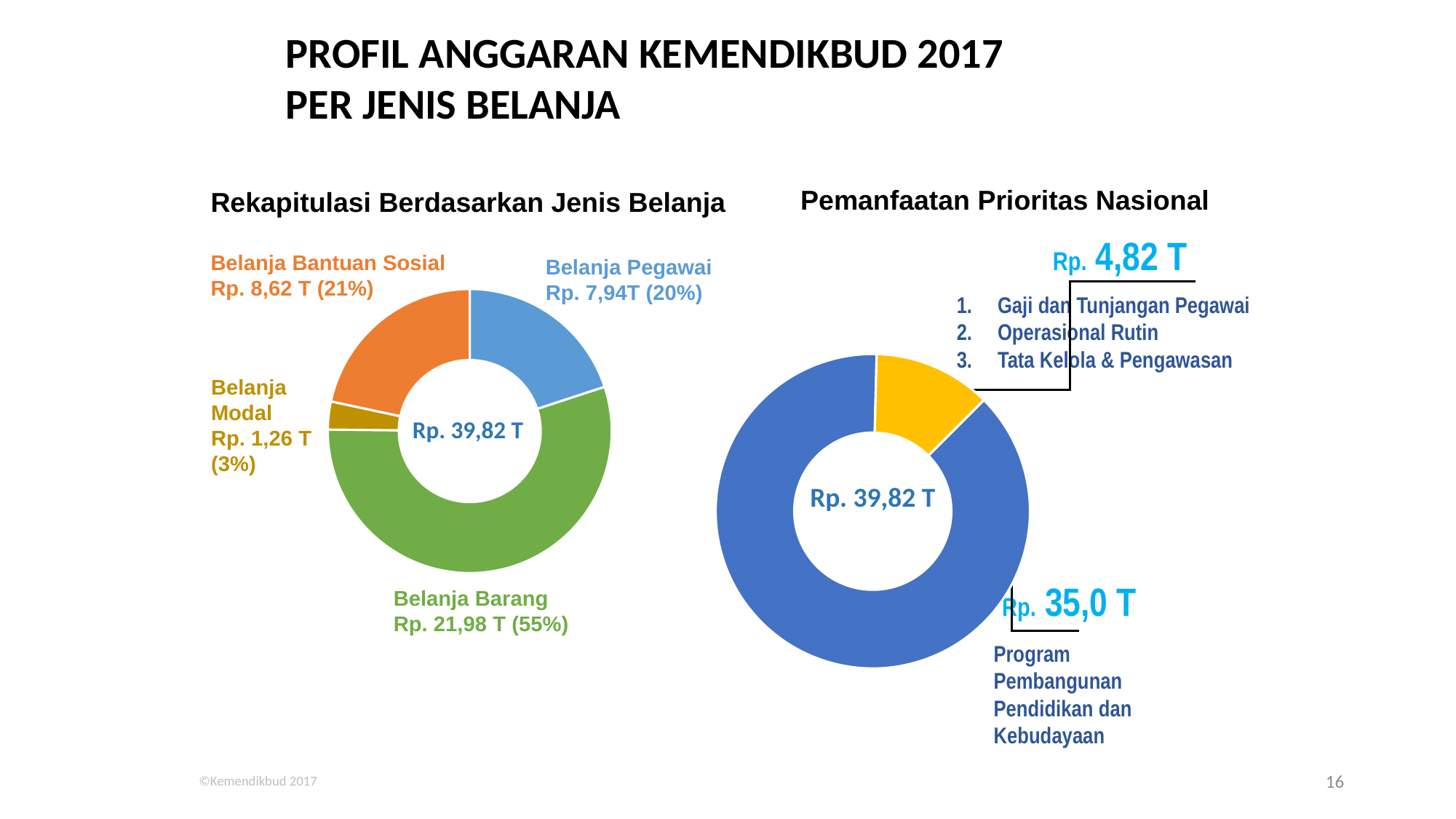
In the 'Pemanfaatan Prioritas Nasional' chart, how many slices does the donut have? 2 In the 'Rekapitulasi Berdasarkan Jenis Belanja' chart, which is larger, Belanja Bantuan Sosial or Belanja Pegawai? Belanja Bantuan Sosial In the 'Rekapitulasi Berdasarkan Jenis Belanja' chart, what share of the total is Belanja Bantuan Sosial? 21% In the 'Rekapitulasi Berdasarkan Jenis Belanja' chart, which category has the largest share? Belanja Barang In the 'Rekapitulasi Berdasarkan Jenis Belanja' chart, what is the value for Belanja Pegawai? Rp. 7,94T (20%) In the 'Pemanfaatan Prioritas Nasional' chart, what is the value of the yellow slice? Rp. 4,82 T In the 'Rekapitulasi Berdasarkan Jenis Belanja' chart, how many categories are shown? 4 In the 'Rekapitulasi Berdasarkan Jenis Belanja' chart, which category has the smallest share? Belanja Modal In the 'Pemanfaatan Prioritas Nasional' chart, what is the value for Program Pembangunan Pendidikan dan Kebudayaan? Rp. 35,0 T What kind of chart is the 'Rekapitulasi Berdasarkan Jenis Belanja' chart? Donut (pie) chart In the 'Rekapitulasi Berdasarkan Jenis Belanja' chart, what is the value for Belanja Barang? Rp. 21,98 T (55%) In the 'Rekapitulasi Berdasarkan Jenis Belanja' chart, what total value is shown in the centre of the donut? Rp. 39,82 T